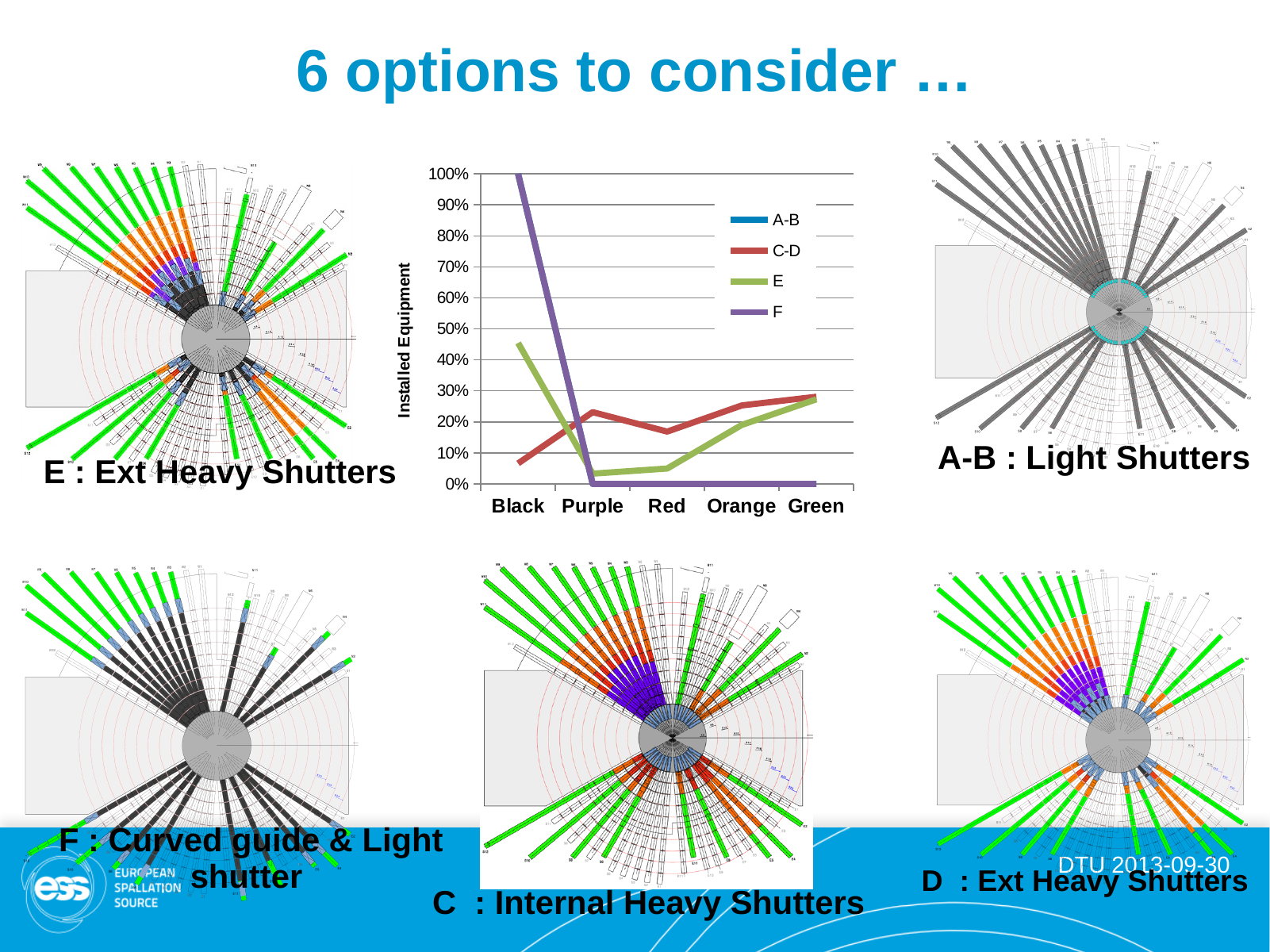
In the line chart, is the value for F at Black greater or less than 90%? greater How many categories are shown on the x axis of the line chart? 5 How many series does the legend of the line chart list? 4 In the line chart, which series has the larger value at Black, E or C-D? E What is the title of the y axis of the line chart? Installed Equipment In the line chart, which category has the highest value for series F? Black In the line chart, is the value for E at Green greater or less than 20%? greater In the line chart, is the value for E at Black greater or less than 40%? greater In the line chart, which series has the larger value at Purple, C-D or E? C-D What kind of chart is shown in the centre of the slide? line chart